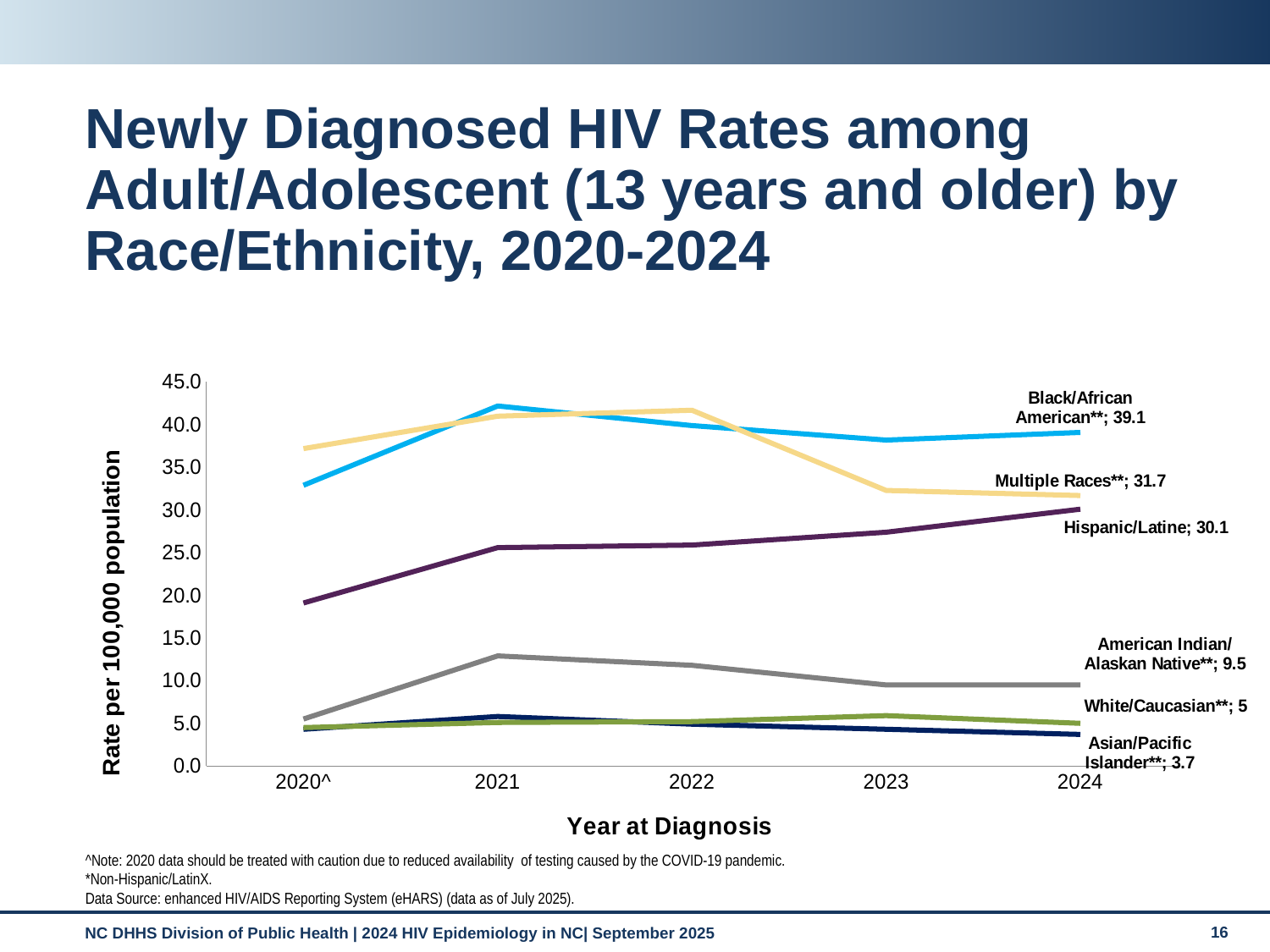
What is the 2024 rate for Black/African American** shown on the chart? 39.1 How many years are shown on the x axis? 5 What is the 2024 rate for Asian/Pacific Islander**? 3.7 Is the 2020^ rate for Hispanic/Latine greater or less than 20.0? less What kind of chart is shown on the slide? Line chart Is the 2021 rate for American Indian/Alaskan Native** greater or less than 10.0? greater Which race/ethnicity group has the highest rate in 2024? Black/African American** In 2024, which is larger: the rate for American Indian/Alaskan Native** or the rate for White/Caucasian**? American Indian/Alaskan Native** What is the 2024 rate for Hispanic/Latine? 30.1 What is the difference between the 2024 rates for Black/African American** and Multiple Races**? 7.4 Which race/ethnicity group has the lowest rate in 2024? Asian/Pacific Islander** How many race/ethnicity groups are plotted as lines on the chart? 6